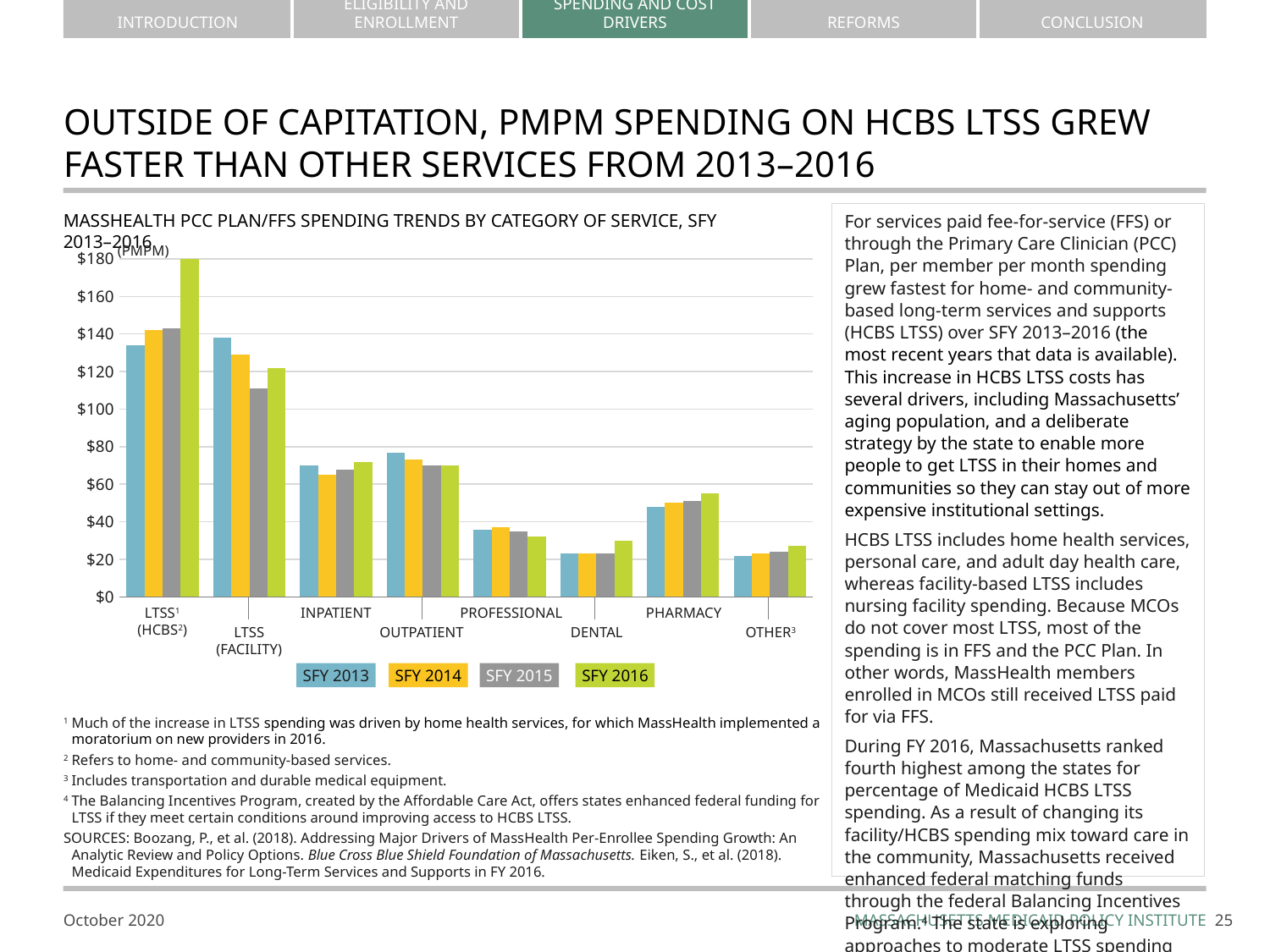
What kind of chart is shown on the slide? Bar chart How many categories of service are shown on the x axis of the chart? 8 Is the SFY 2015 value for LTSS (FACILITY) greater or less than $120? less For SFY 2016, which is larger: LTSS (HCBS) or LTSS (FACILITY)? LTSS (HCBS) Is the SFY 2013 value for OUTPATIENT greater or less than $60? greater Do the LTSS (HCBS) values rise or fall from SFY 2013 to SFY 2016? rise Within the LTSS (FACILITY) category, which fiscal year has the lowest bar? SFY 2015 Within the LTSS (HCBS) category, which fiscal year has the lowest bar? SFY 2013 How many series does the chart's legend list? 4 Is the SFY 2016 value for PHARMACY greater or less than $40? greater Which category and year has the tallest bar in the chart? LTSS (HCBS), SFY 2016